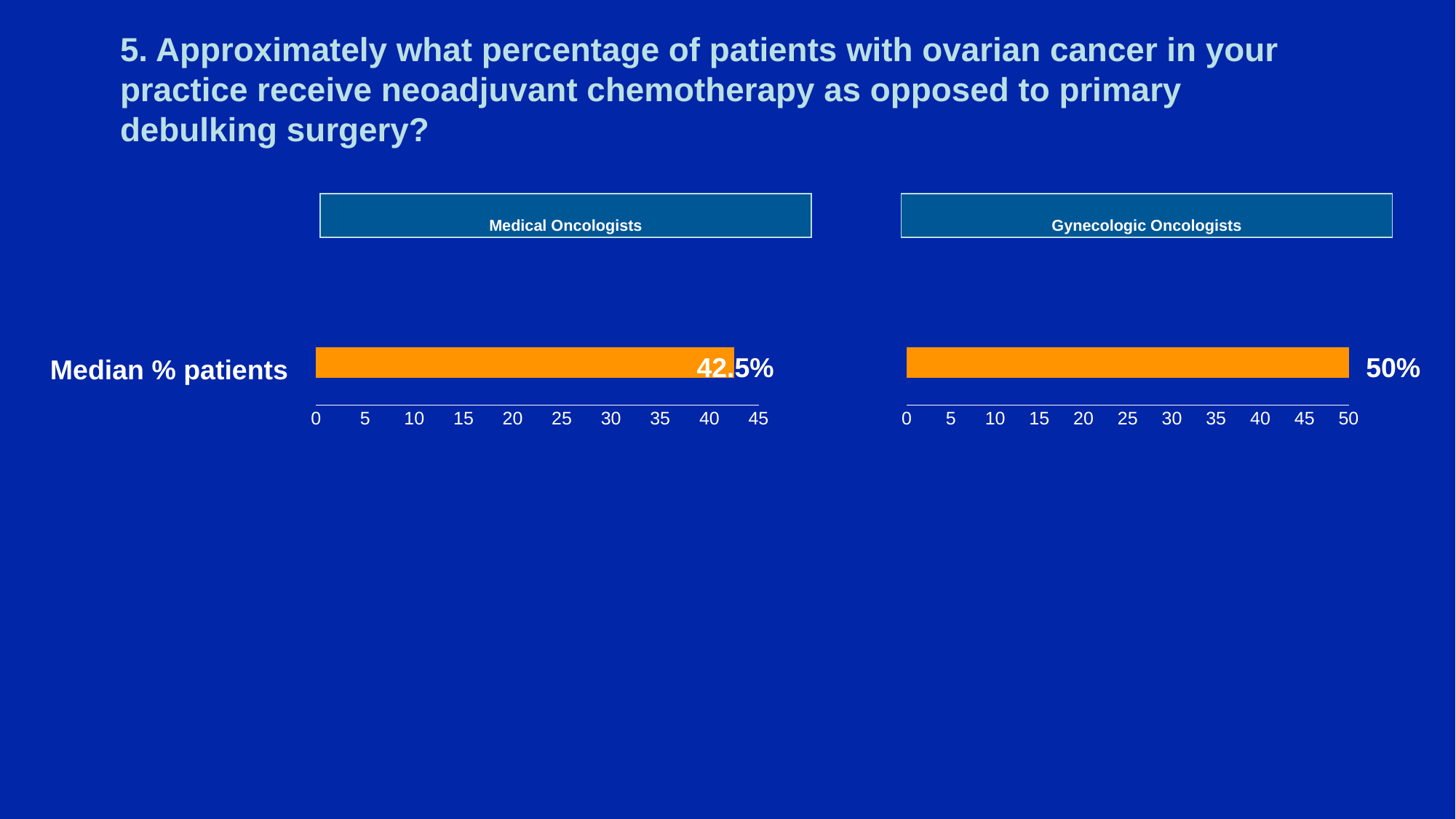
In the Gynecologic Oncologists chart, what is the median % of patients receiving neoadjuvant chemotherapy? 50% What is the highest tick value on the x axis of the Medical Oncologists chart? 45 Which group reports the higher median % of patients, Medical Oncologists or Gynecologic Oncologists? Gynecologic Oncologists In the Medical Oncologists chart, is the value for Median % patients greater or less than 40? greater How many bars are shown in the Gynecologic Oncologists chart? 1 What colour are the bars in both charts? Orange What kind of chart is used for the Medical Oncologists data? Bar chart In the Medical Oncologists chart, what is the median % of patients receiving neoadjuvant chemotherapy? 42.5% In the Gynecologic Oncologists chart, is the value for Median % patients greater or less than 45? greater What is the difference between the Gynecologic Oncologists' median (50%) and the Medical Oncologists' median (42.5%)? 7.5%